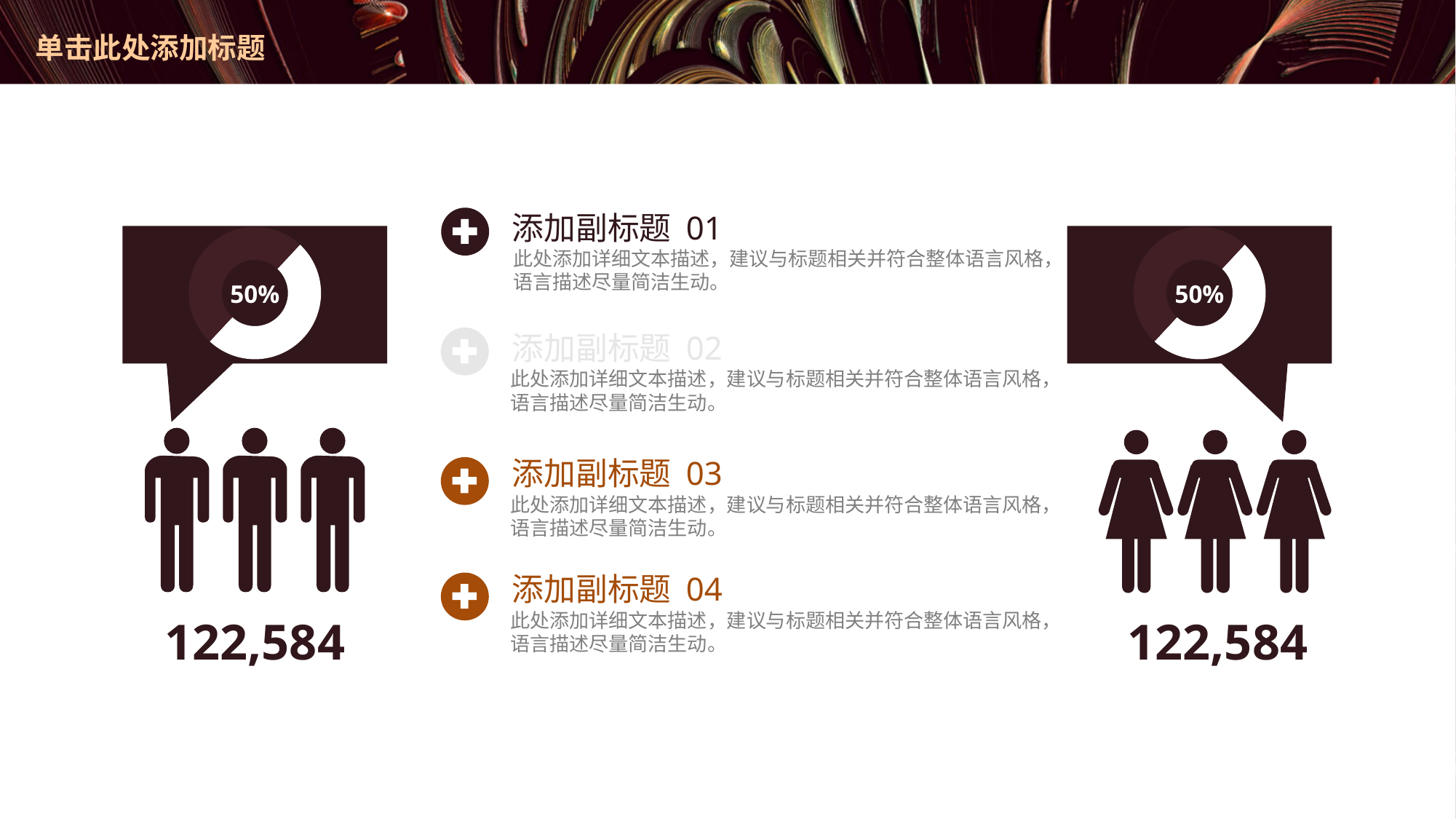
What number is printed below the female figures under the right chart? 122,584 How many person icons are shown below the left chart? 3 What percentage is shown in the donut chart on the right side of the slide? 50% What percentage is shown in the donut chart on the left side of the slide? 50% Is the percentage in the left donut chart larger than, smaller than, or equal to the percentage in the right donut chart? Equal What share of the left donut chart does the filled (white) segment represent? 50% How many donut charts are shown on the slide? 2 What kind of chart is shown inside the speech-bubble shape on the left side of the slide? Donut (pie) chart What colour is the filled segment of the donut charts? White What type of figure icons appear below the right chart? Female figures What number is printed below the male figures under the left chart? 122,584